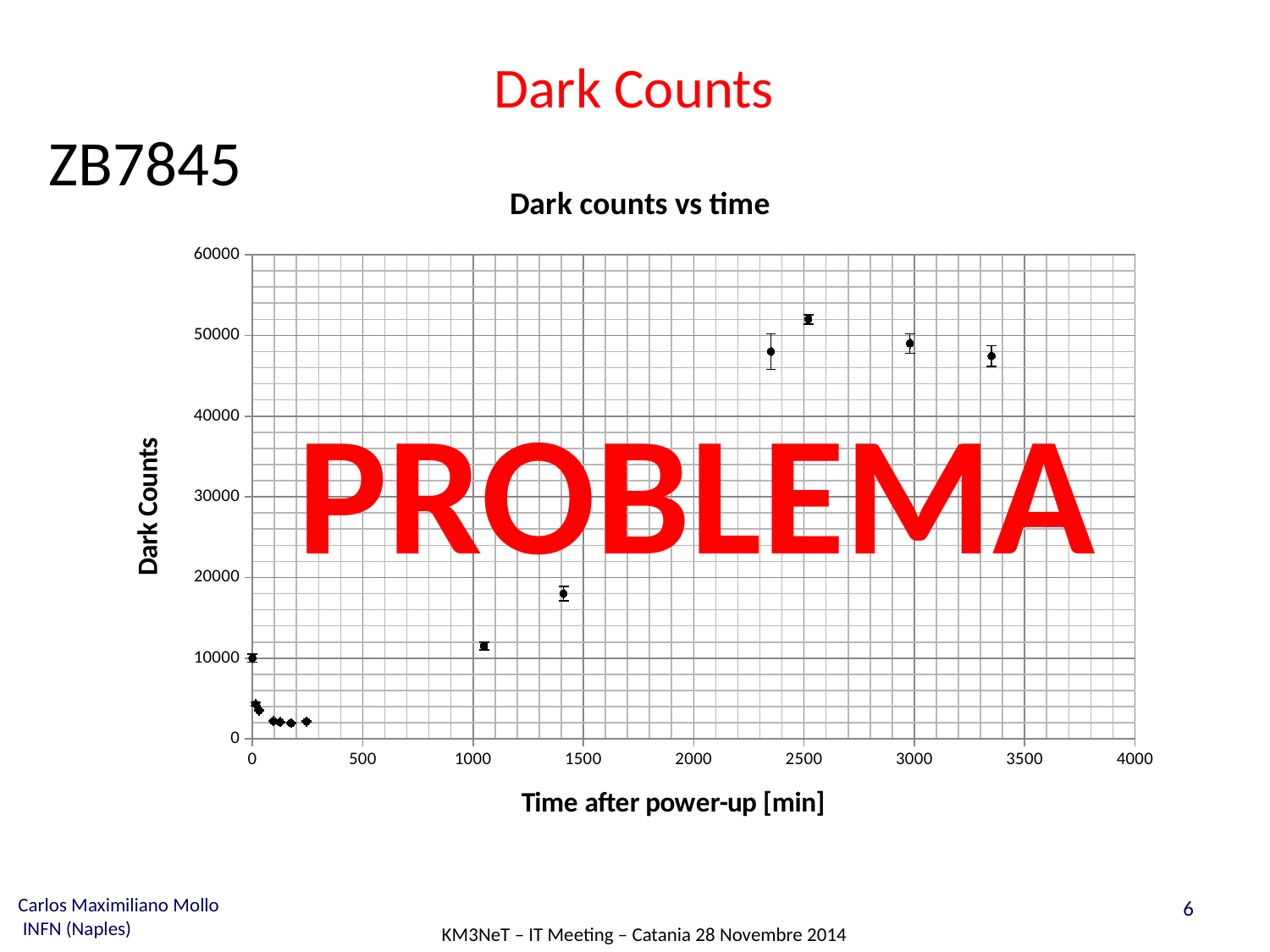
What is the label of the x axis of the chart? Time after power-up [min] Are the dark count values of the points between 100 and 300 min greater or less than 5000? less Is the dark count value of the point near 1050 min greater or less than 10000? greater Is the dark count value of the point near 1400 min greater or less than 20000? less What is the title of the chart? Dark counts vs time What is the maximum value shown on the y axis of the chart? 60000 Which has the larger dark count value: the point near 2500 min or the point near 1400 min? the point near 2500 min What kind of chart is shown on the slide? scatter chart Do the dark counts at times after 2000 min lie above or below the dark counts at times before 500 min? above